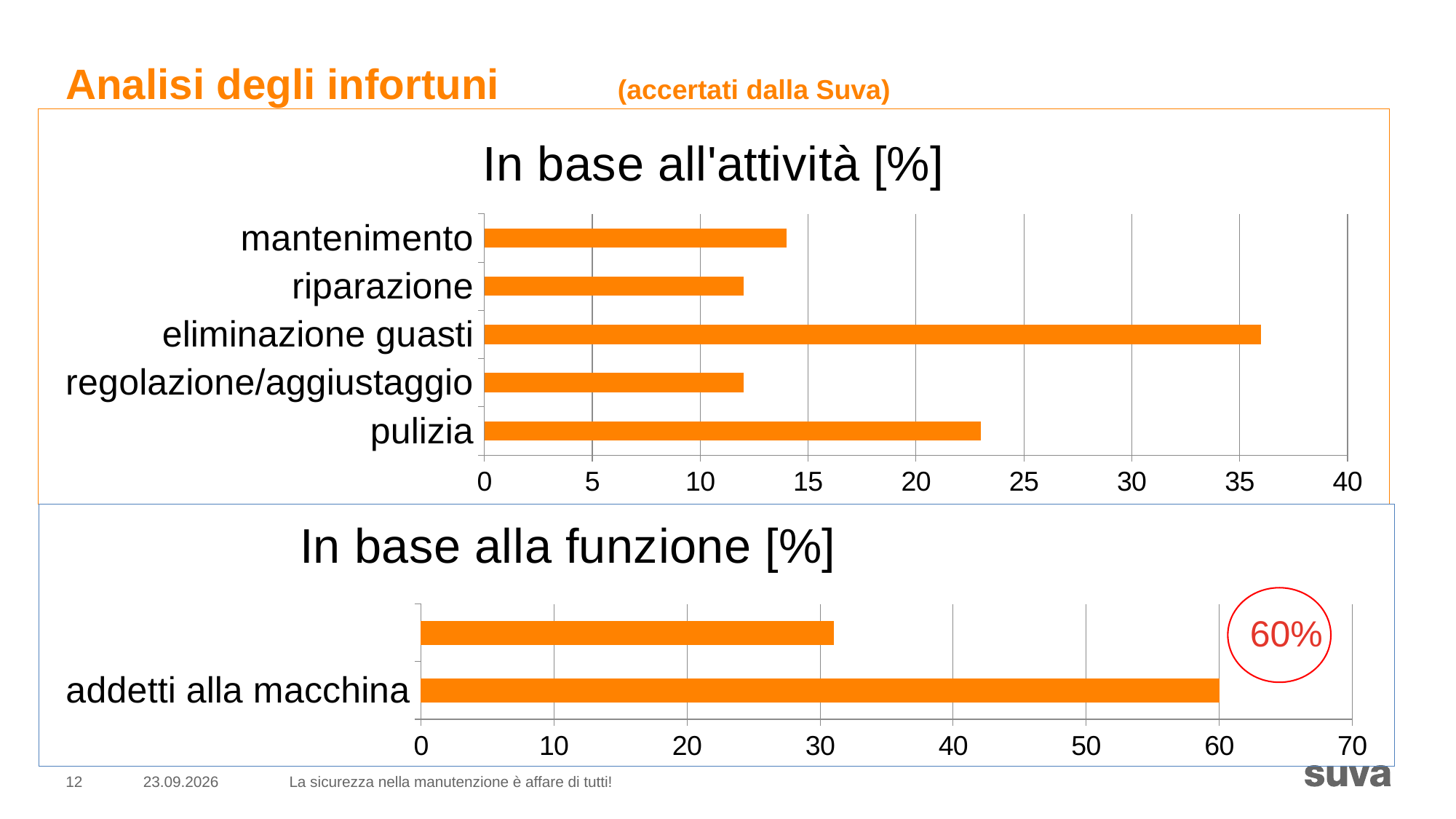
In the chart titled "In base alla funzione [%]", is the value of the upper, unlabeled bar greater or less than 40? less In the chart titled "In base all'attività [%]", which activity has the highest value? eliminazione guasti In the chart titled "In base all'attività [%]", is the value for pulizia greater or less than 20? greater In the chart titled "In base all'attività [%]", is the value for eliminazione guasti greater or less than 30? greater In the chart titled "In base all'attività [%]", how many activity categories are shown? 5 In the chart titled "In base all'attività [%]", which is larger, the value for pulizia or the value for mantenimento? pulizia What kind of chart is "In base all'attività [%]"? bar chart In the chart titled "In base alla funzione [%]", how many bars are plotted? 2 In the chart titled "In base alla funzione [%]", what value is shown for addetti alla macchina? 60% What is the title of the lower chart on the slide? In base alla funzione [%]